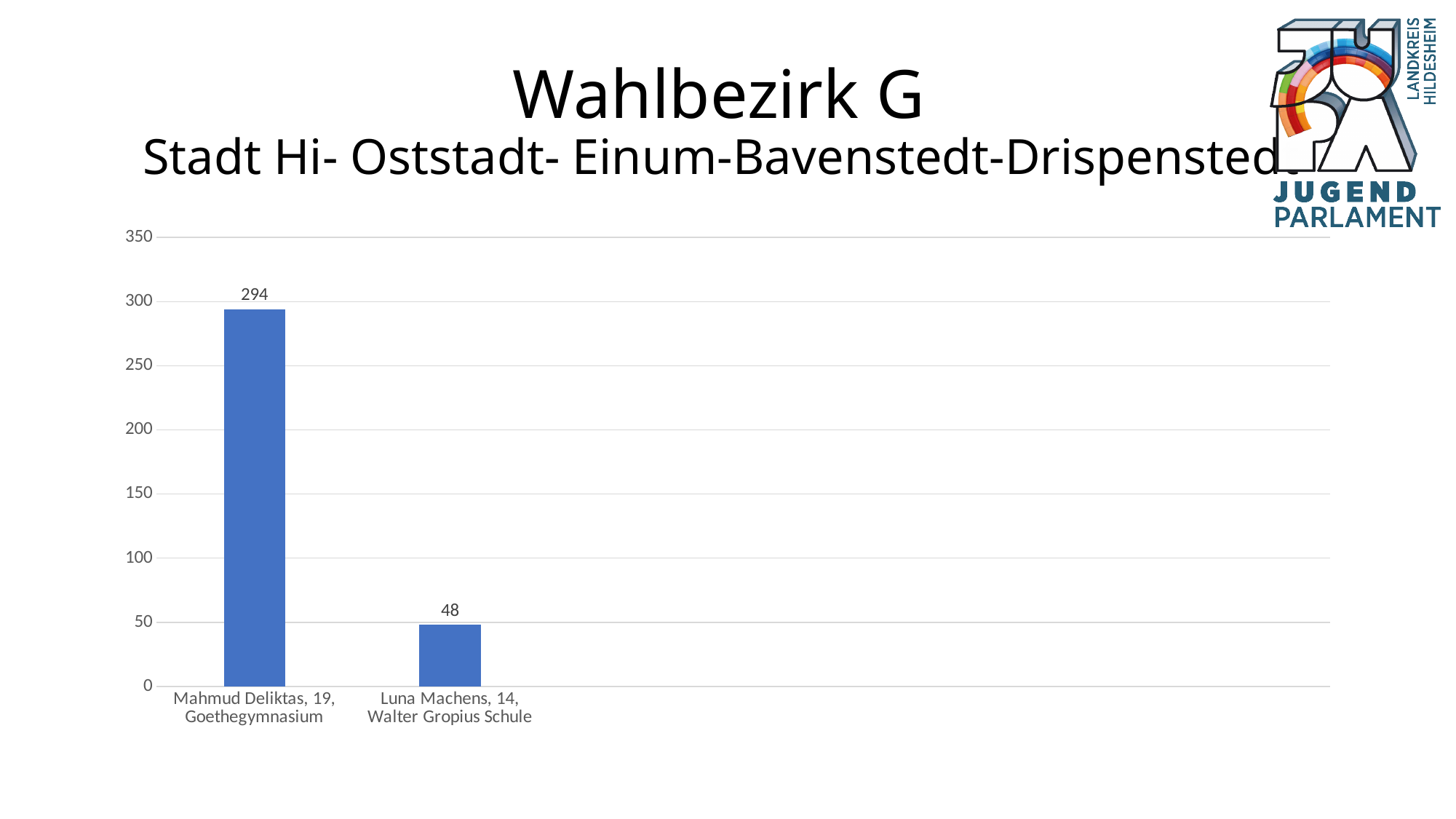
What value is shown for Luna Machens, 14, Walter Gropius Schule? 48 What is the difference between the values for Mahmud Deliktas and Luna Machens? 246 How many candidates are shown in the chart? 2 Which candidate has the highest value? Mahmud Deliktas, 19, Goethegymnasium Which candidate has the lowest value? Luna Machens, 14, Walter Gropius Schule What kind of chart is shown on the slide? bar chart What value is shown for Mahmud Deliktas, 19, Goethegymnasium? 294 What is the highest value shown on the vertical axis? 350 Is the value for Mahmud Deliktas greater or less than 250? greater Is the value for Luna Machens greater or less than 100? less Which is larger, the value for Mahmud Deliktas or the value for Luna Machens? Mahmud Deliktas What is the main title of the slide? Wahlbezirk G